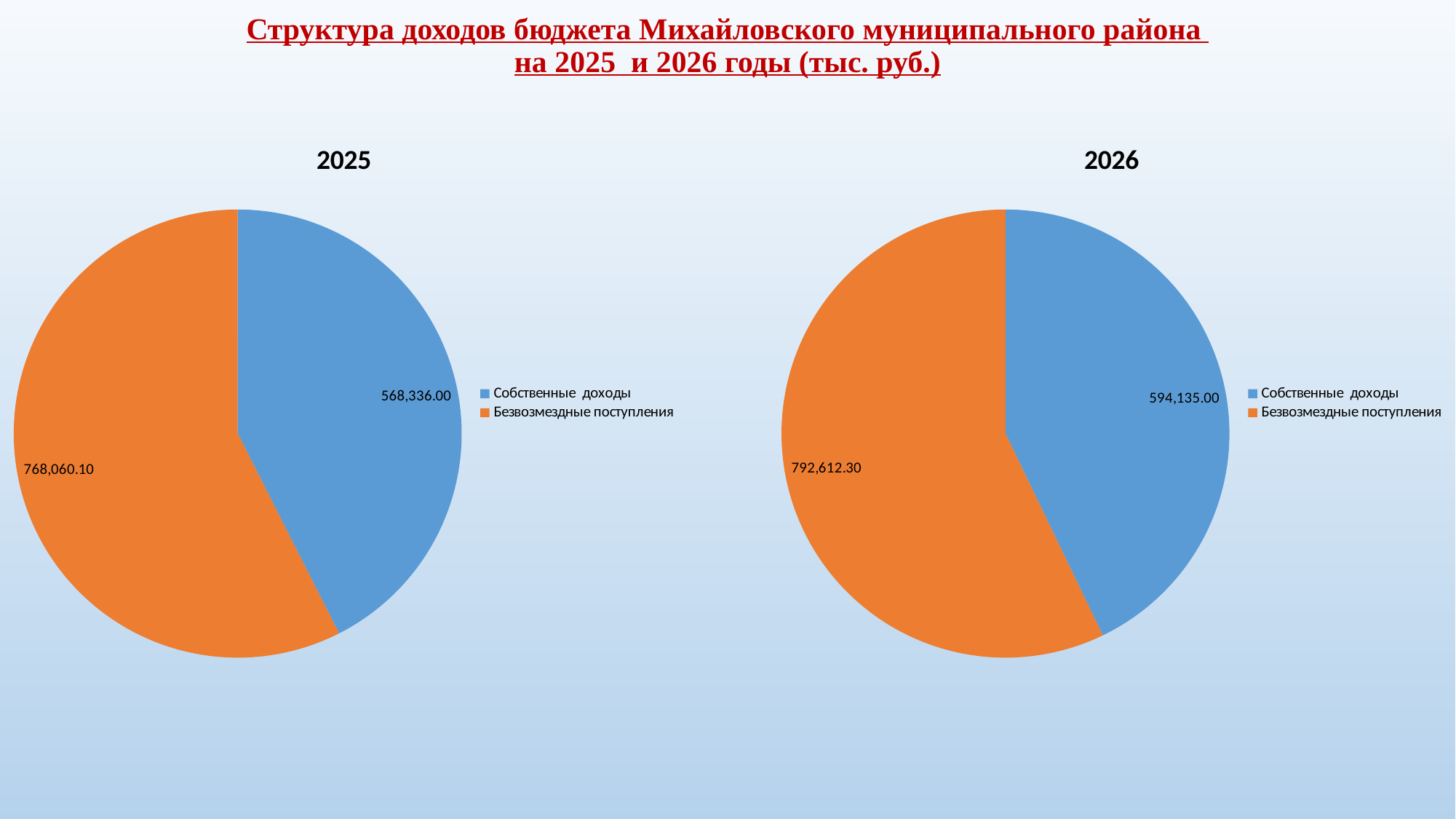
In the 2026 pie chart, what is the value for Безвозмездные поступления? 792,612.30 In the 2025 pie chart, what is the value for Собственные доходы? 568,336.00 In the 2026 pie chart, which category has the smallest slice? Собственные доходы In the 2025 pie chart, what is the value for Безвозмездные поступления? 768,060.10 What type of chart is used for the 2026 data? Pie chart In the 2026 pie chart, what is the value for Собственные доходы? 594,135.00 Is the value for Собственные доходы larger in the 2025 chart or in the 2026 chart? 2026 In the 2025 pie chart, which category has the largest slice? Безвозмездные поступления In the 2026 pie chart, what is the difference between Безвозмездные поступления and Собственные доходы? 198,477.30 What is the total of the two slices in the 2026 pie chart? 1,386,747.30 How many slices does the 2025 pie chart have? 2 In the 2025 pie chart, what is the difference between Безвозмездные поступления and Собственные доходы? 199,724.10